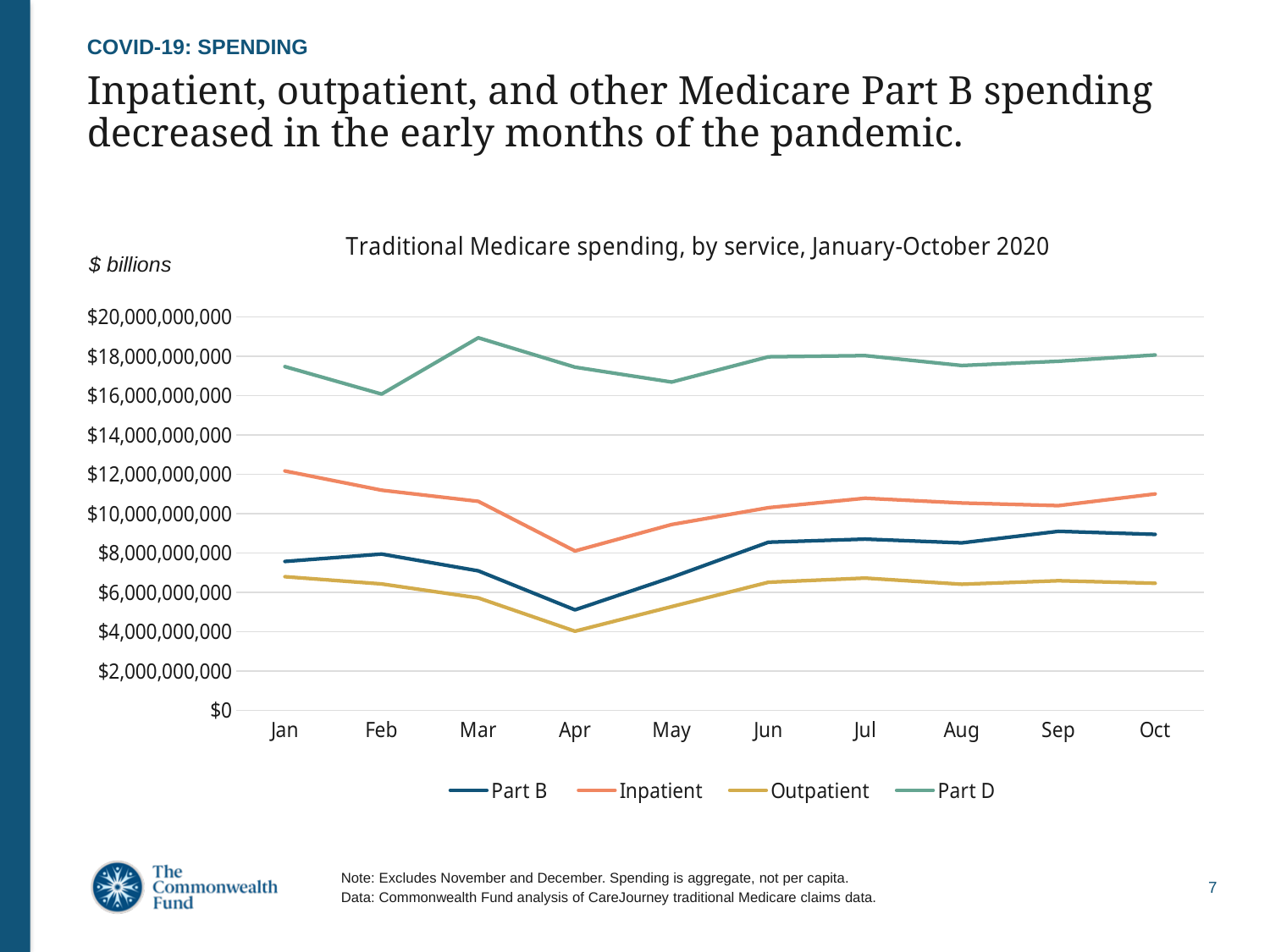
Is the Part D value for Mar greater or less than $18,000,000,000? greater How many months are plotted along the x axis? 10 In which month is Outpatient spending lowest? Apr What unit label is shown above the y axis? $ billions Is the Part B value for Apr greater or less than $6,000,000,000? less What kind of chart is shown on the slide? Line chart Does Inpatient spending rise or fall from Jan to Apr? Fall Which series has the higher value in Jul, Part D or Inpatient? Part D What is the title of the chart? Traditional Medicare spending, by service, January-October 2020 In which month is Part D spending highest? Mar How many series does the legend list? 4 In which month is Inpatient spending lowest? Apr